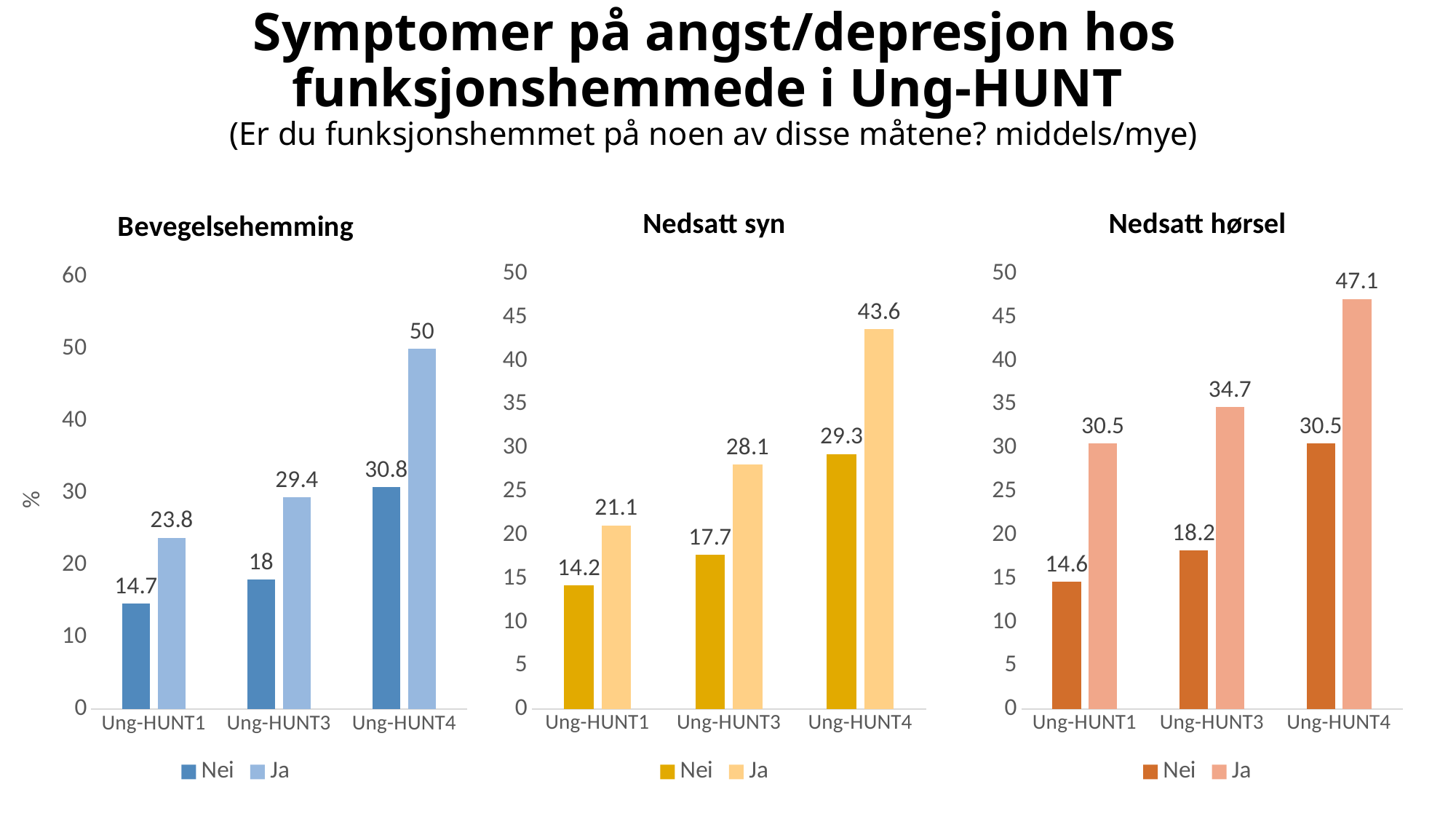
In the Nedsatt syn chart, what is the difference between Ja and Nei in Ung-HUNT4? 14.3 In the Bevegelsehemming chart, which is larger in Ung-HUNT3: Nei or Ja? Ja How many series does the legend of the Nedsatt syn chart list? 2 In the Nedsatt hørsel chart, which category has the highest Ja value? Ung-HUNT4 In the Bevegelsehemming chart, do the Ja values rise or fall from Ung-HUNT1 to Ung-HUNT4? rise How many categories are shown on the x axis of the Nedsatt hørsel chart? 3 In the Nedsatt syn chart, what is the value for Nei in Ung-HUNT3? 17.7 In the Bevegelsehemming chart, what is the value for Ja in Ung-HUNT4? 50 In the Nedsatt hørsel chart, what is the value for Ja in Ung-HUNT1? 30.5 In the Nedsatt hørsel chart, what is the difference between the Ja values for Ung-HUNT4 and Ung-HUNT1? 16.6 In the Bevegelsehemming chart, which category has the lowest Nei value? Ung-HUNT1 In the Nedsatt syn chart, is the Ja value for Ung-HUNT4 greater or less than 40? greater